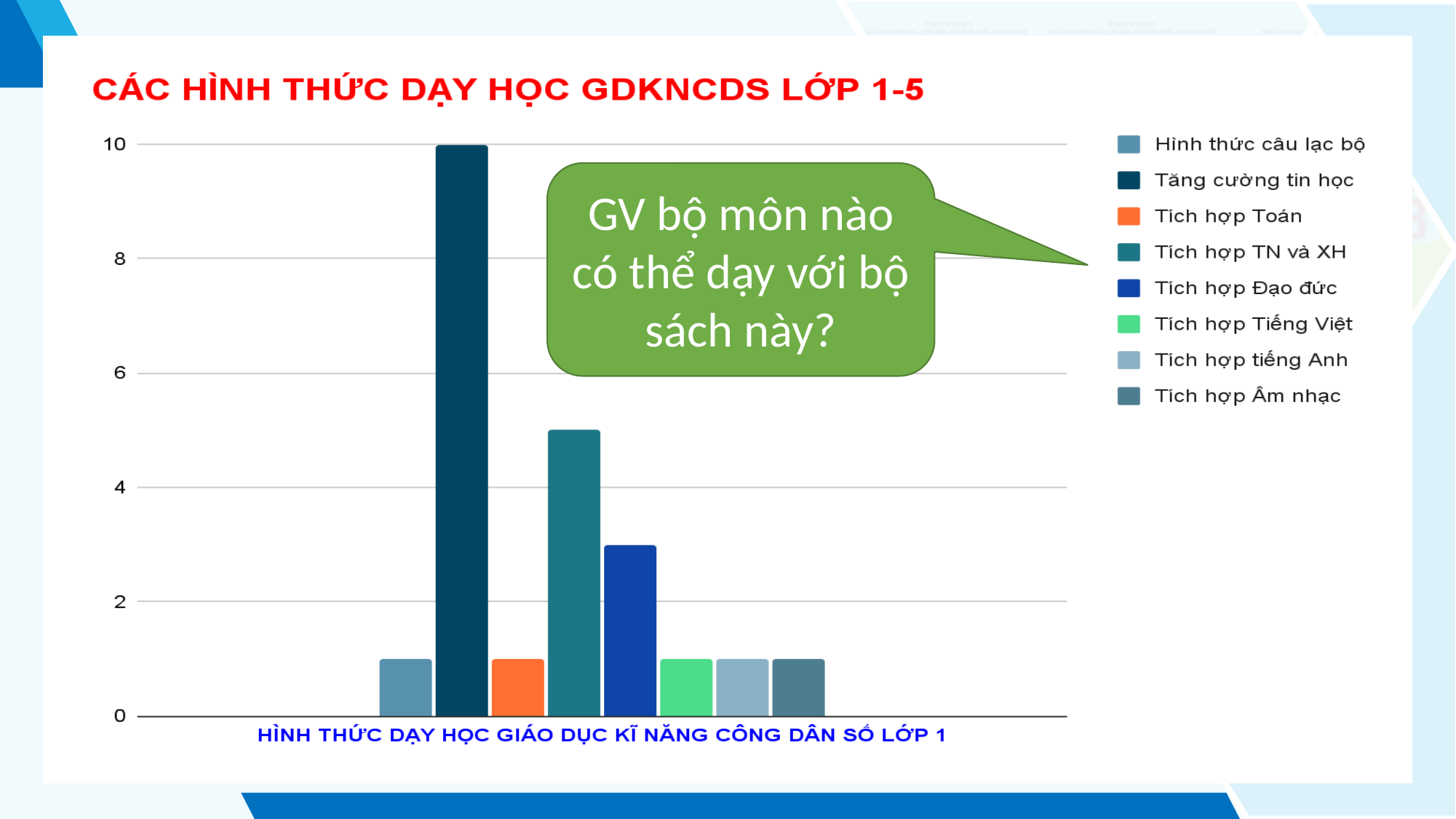
Is the value for Tích hợp TN và XH greater or less than 6? less What type of chart is shown on the slide? bar chart How many series does the legend list? 8 Is the value for Tích hợp TN và XH greater or less than 4? greater What is the title of the chart? CÁC HÌNH THỨC DẠY HỌC GDKNCDS LỚP 1-5 Is the value for Tích hợp Toán greater or less than 2? less What is the label shown on the x axis of the chart? HÌNH THỨC DẠY HỌC GIÁO DỤC KĨ NĂNG CÔNG DÂN SỐ LỚP 1 What is the value for Tăng cường tin học? 10 Which is larger, the value for Tích hợp TN và XH or the value for Tích hợp Đạo đức? Tích hợp TN và XH Which series has the highest bar? Tăng cường tin học